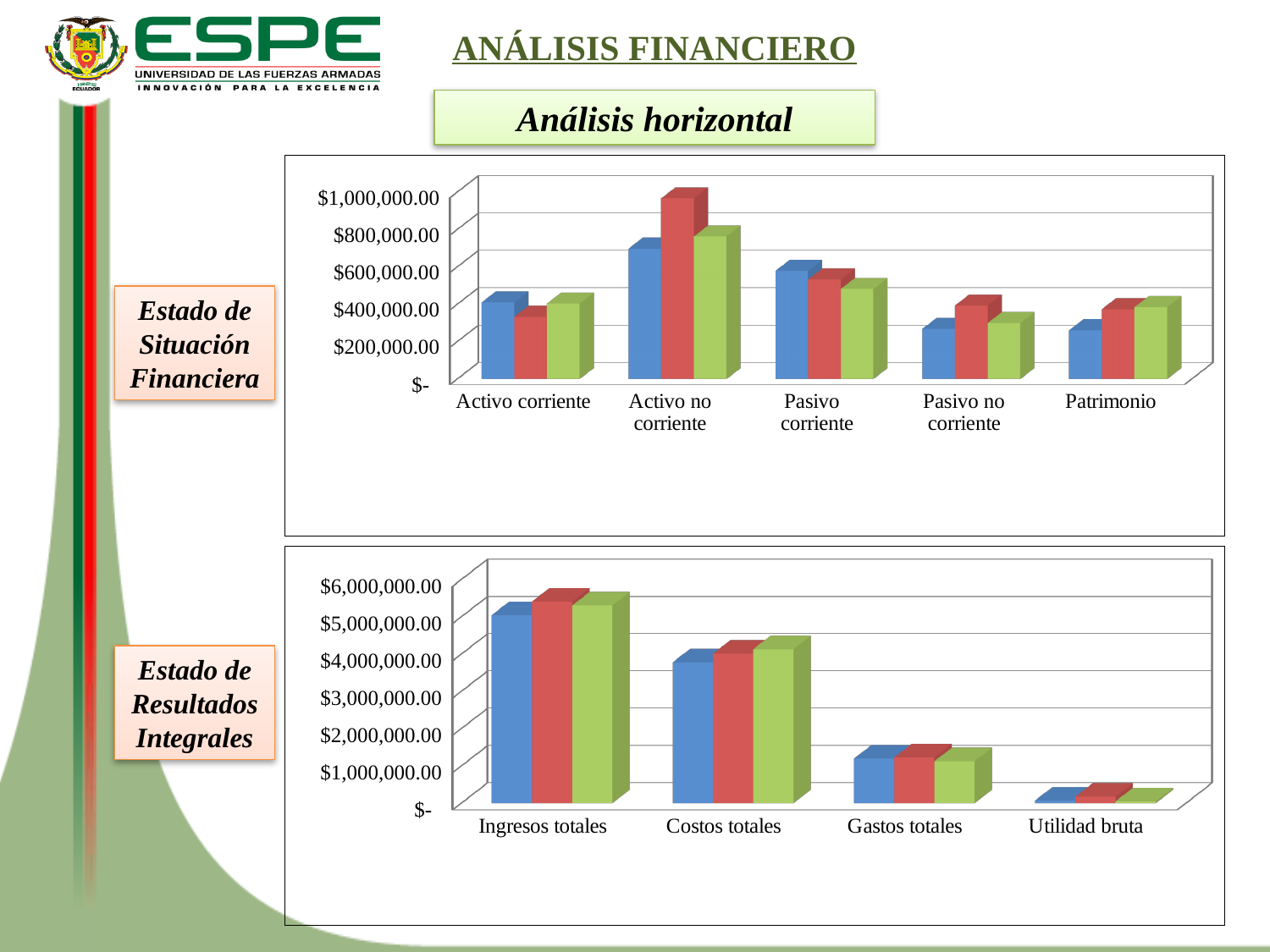
In the top chart (Estado de Situación Financiera), which category has larger values, Activo corriente or Activo no corriente? Activo no corriente What is the title shown in the green box above the charts? Análisis horizontal How many categories are shown on the x axis of the bottom chart (Estado de Resultados Integrales)? 4 What kind of chart is the top chart (Estado de Situación Financiera)? Bar chart In the bottom chart (Estado de Resultados Integrales), which category has the highest values? Ingresos totales In the top chart (Estado de Situación Financiera), which category has the tallest bar? Activo no corriente How many categories are shown on the x axis of the top chart (Estado de Situación Financiera)? 5 In the top chart (Estado de Situación Financiera), is the red bar for Activo no corriente greater or less than $800,000.00? greater In the bottom chart (Estado de Resultados Integrales), is the red bar for Ingresos totales greater or less than $5,000,000.00? greater In the bottom chart (Estado de Resultados Integrales), do the values rise or fall moving from Ingresos totales to Utilidad bruta along the x axis? fall In the bottom chart (Estado de Resultados Integrales), which category has the lowest values? Utilidad bruta In the top chart (Estado de Situación Financiera), is the blue bar for Activo no corriente greater or less than $600,000.00? greater